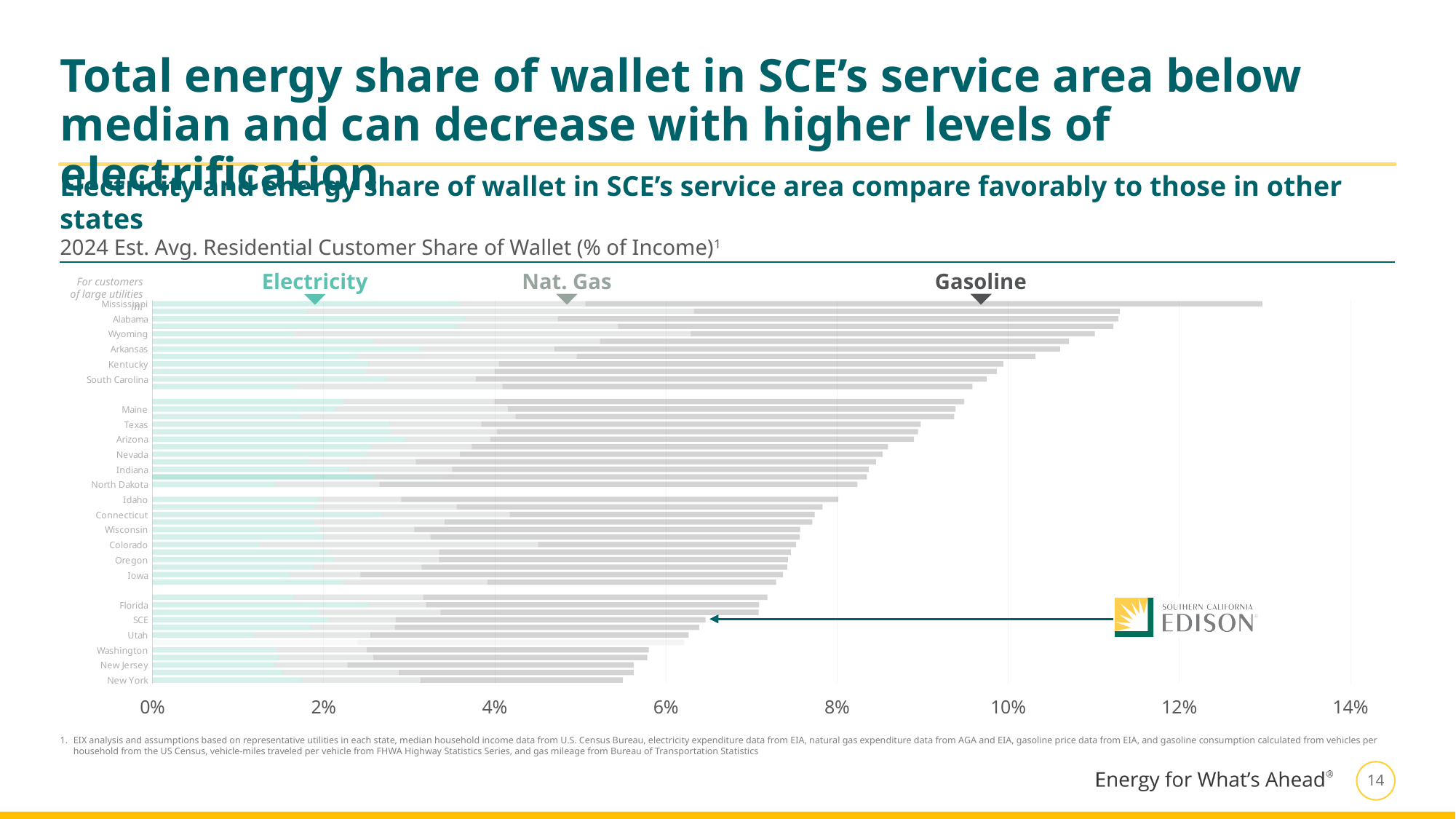
Which state has the highest total energy share of wallet? Mississippi Is the total share of wallet for Alabama greater or less than 10%? greater Is the total share of wallet for New York greater or less than 6%? less What kind of chart is shown on the slide? Stacked horizontal bar chart How many series does the chart's legend list? 3 Do the total bar lengths increase or decrease going from the top of the chart to the bottom? Decrease Is the total share of wallet for SCE greater or less than 6%? greater What are the three series shown in the chart? Electricity, Nat. Gas, Gasoline Which has a larger total share of wallet, Florida or SCE? Florida Which labeled state has the lowest total energy share of wallet? New York